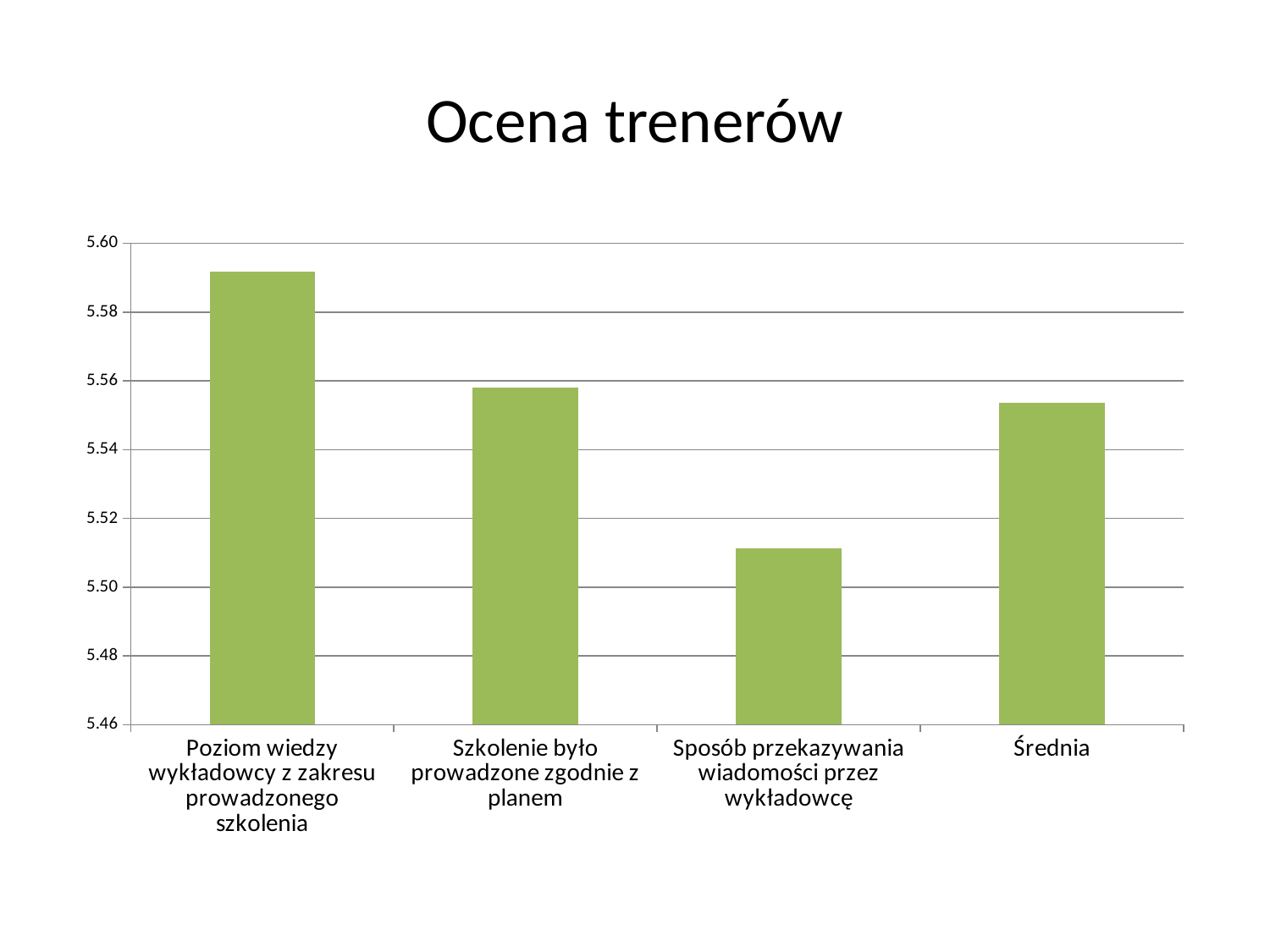
Is the value for 'Sposób przekazywania wiadomości przez wykładowcę' greater or less than 5.52? less Which category has the highest value? Poziom wiedzy wykładowcy z zakresu prowadzonego szkolenia Which category has the lowest value? Sposób przekazywania wiadomości przez wykładowcę Is the value for 'Sposób przekazywania wiadomości przez wykładowcę' greater or less than 5.50? greater What is the title of the chart? Ocena trenerów What kind of chart is shown on the slide? bar chart Which is larger: the value for 'Poziom wiedzy wykładowcy z zakresu prowadzonego szkolenia' or the value for 'Średnia'? Poziom wiedzy wykładowcy z zakresu prowadzonego szkolenia How many categories are shown on the x axis? 4 Which is larger: the value for 'Szkolenie było prowadzone zgodnie z planem' or the value for 'Sposób przekazywania wiadomości przez wykładowcę'? Szkolenie było prowadzone zgodnie z planem Is the value for 'Szkolenie było prowadzone zgodnie z planem' greater or less than 5.54? greater